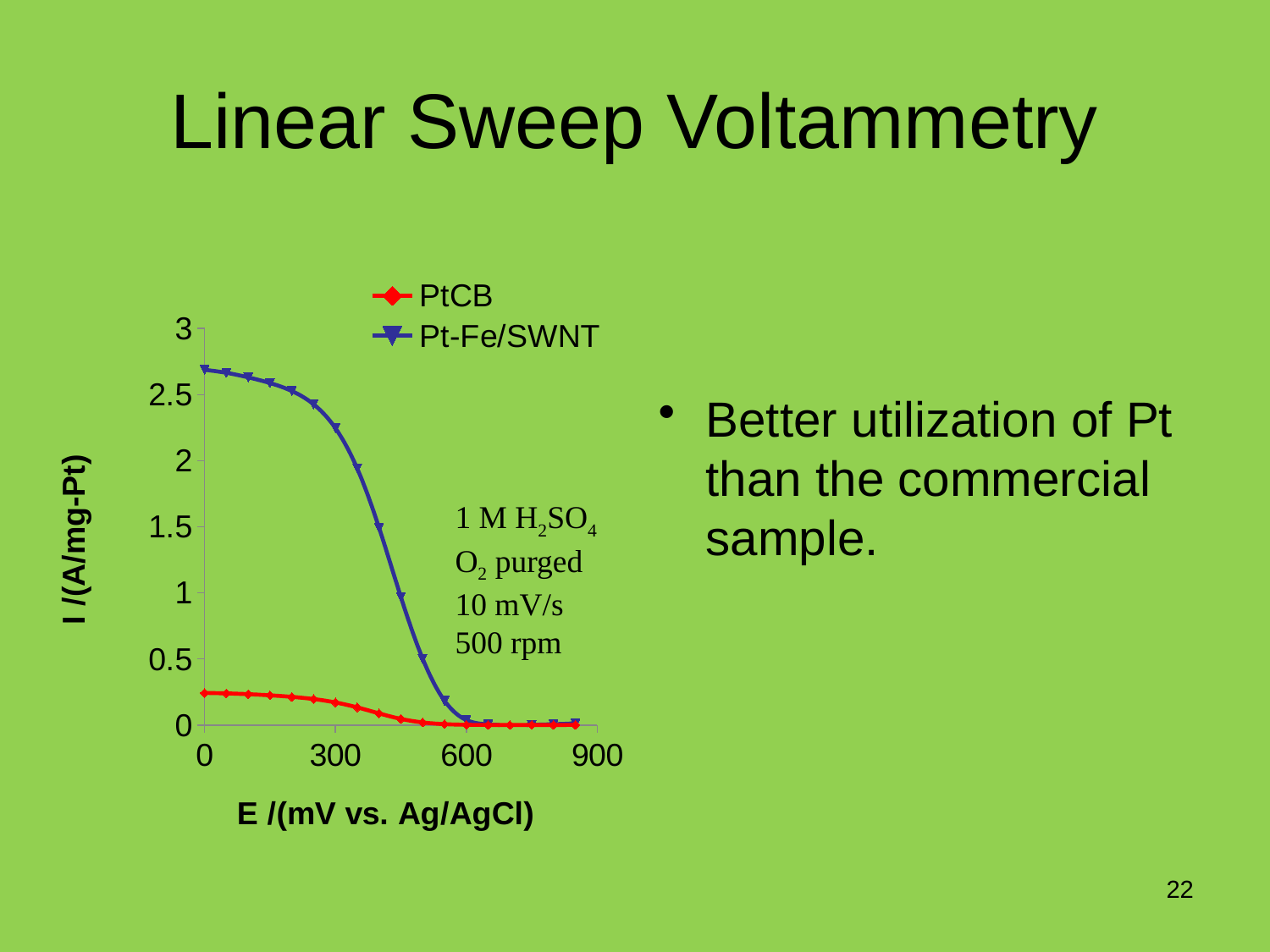
Which two series are listed in the legend? PtCB and Pt-Fe/SWNT How many series does the legend list? 2 At 0 mV, which series has the higher current, PtCB or Pt-Fe/SWNT? Pt-Fe/SWNT What is the label of the x axis? E /(mV vs. Ag/AgCl) Which series reaches the highest current value on the chart? Pt-Fe/SWNT Does the Pt-Fe/SWNT current rise or fall as E increases from 0 to 900 mV? Fall Is the value for Pt-Fe/SWNT at 0 mV greater or less than 2.5? greater What kind of chart is shown on the slide? Line chart Is the value for PtCB at 0 mV greater or less than 0.5? less Is the value for Pt-Fe/SWNT at 600 mV greater or less than 0.5? less Does the PtCB current rise or fall as E increases along the x axis? Fall